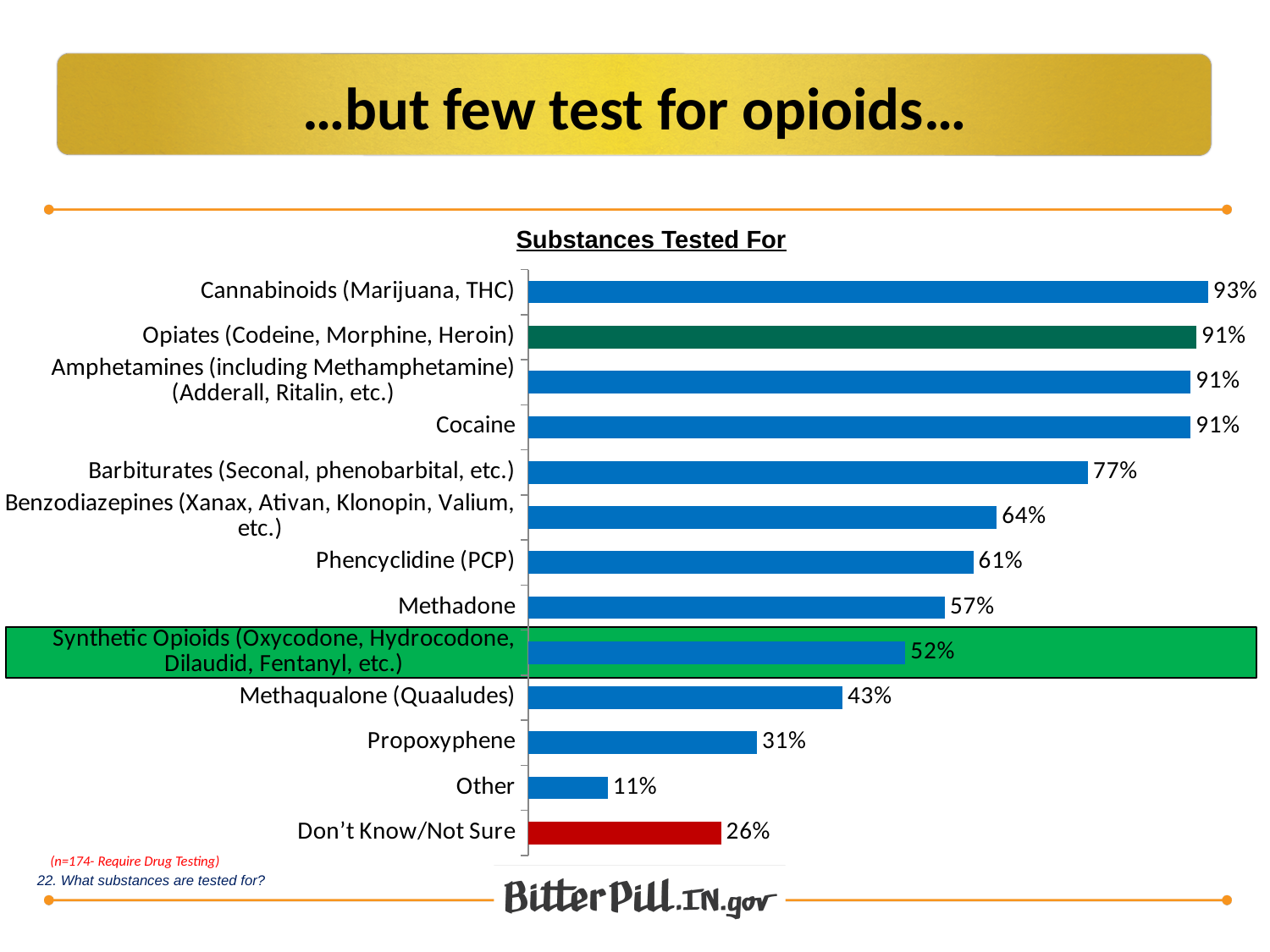
What percentage is shown for Cannabinoids (Marijuana, THC)? 93% Which has a higher percentage, Barbiturates or Benzodiazepines? Barbiturates (Seconal, phenobarbital, etc.) How many categories are shown in the chart? 13 Which category has the lowest percentage in the chart? Other Which category's bar is coloured red? Don't Know/Not Sure Which substance has the highest percentage tested for? Cannabinoids (Marijuana, THC) What is the title of the chart? Substances Tested For What percentage is shown for Don't Know/Not Sure? 26% What percentage is shown for Methadone? 57% What type of chart is shown on the slide? Bar chart What is the difference between the percentages for Opiates (Codeine, Morphine, Heroin) and Synthetic Opioids? 39% What percentage is shown for Synthetic Opioids (Oxycodone, Hydrocodone, Dilaudid, Fentanyl, etc.)? 52%